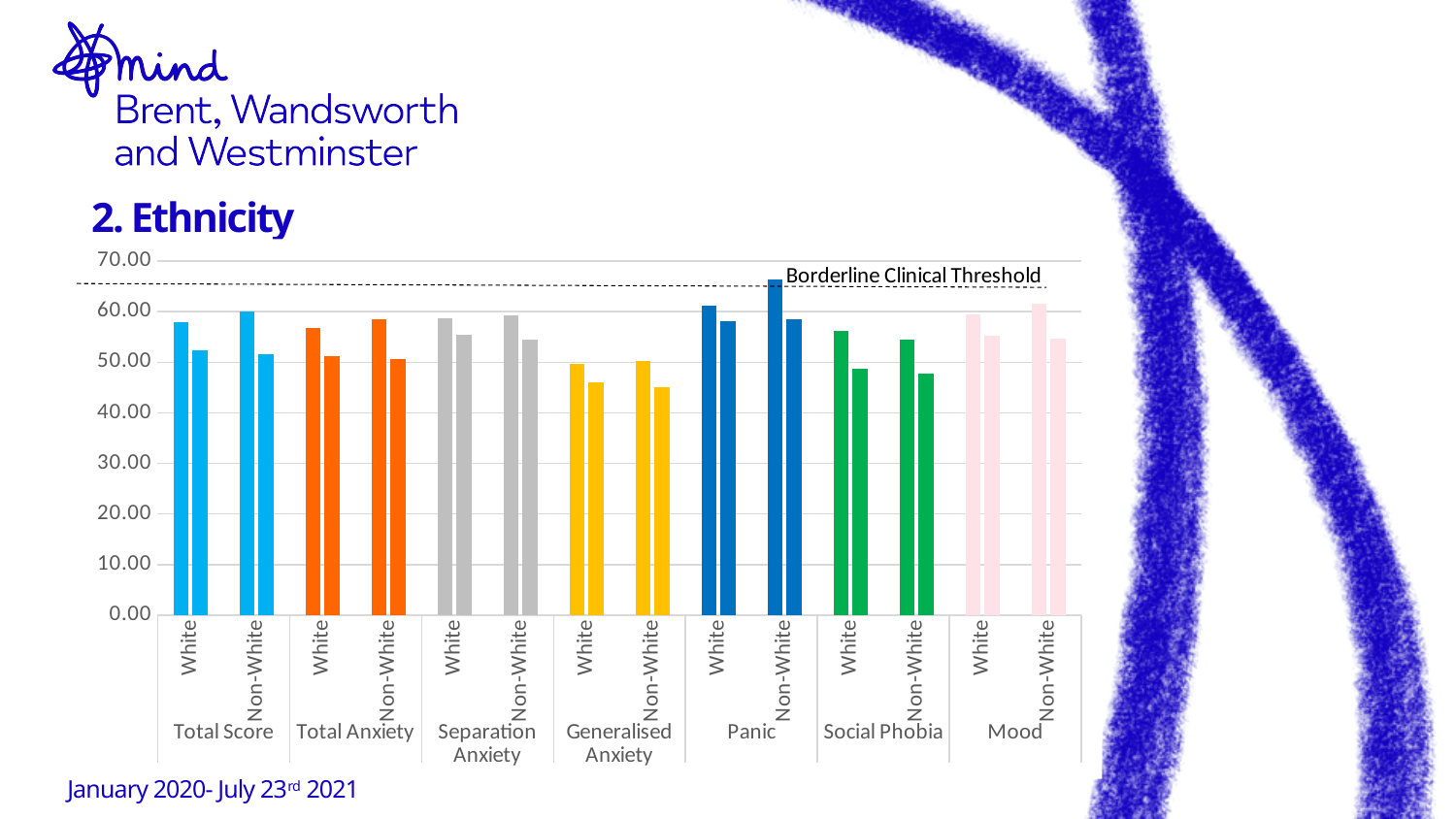
What is the title of the chart on the slide? 2. Ethnicity Is the second (right) bar for Non-White under Generalised Anxiety greater or less than 50? less Is the first (left) bar for Non-White under Panic greater or less than 60? greater Which is larger: the first bar for Non-White under Panic or the first bar for White under Generalised Anxiety? Non-White under Panic Is the second (right) bar for Non-White under Social Phobia greater or less than 50? less What does the dashed horizontal line near the top of the chart represent? Borderline Clinical Threshold Which category group has the lowest bars in the chart? Generalised Anxiety How many category groups (e.g. Total Score, Panic) are shown along the x axis? 7 What kind of chart is shown on the slide? bar chart Which category group contains the tallest bar in the chart? Panic Within each White/Non-White pair, is the first (left) bar taller or shorter than the second (right) bar? taller